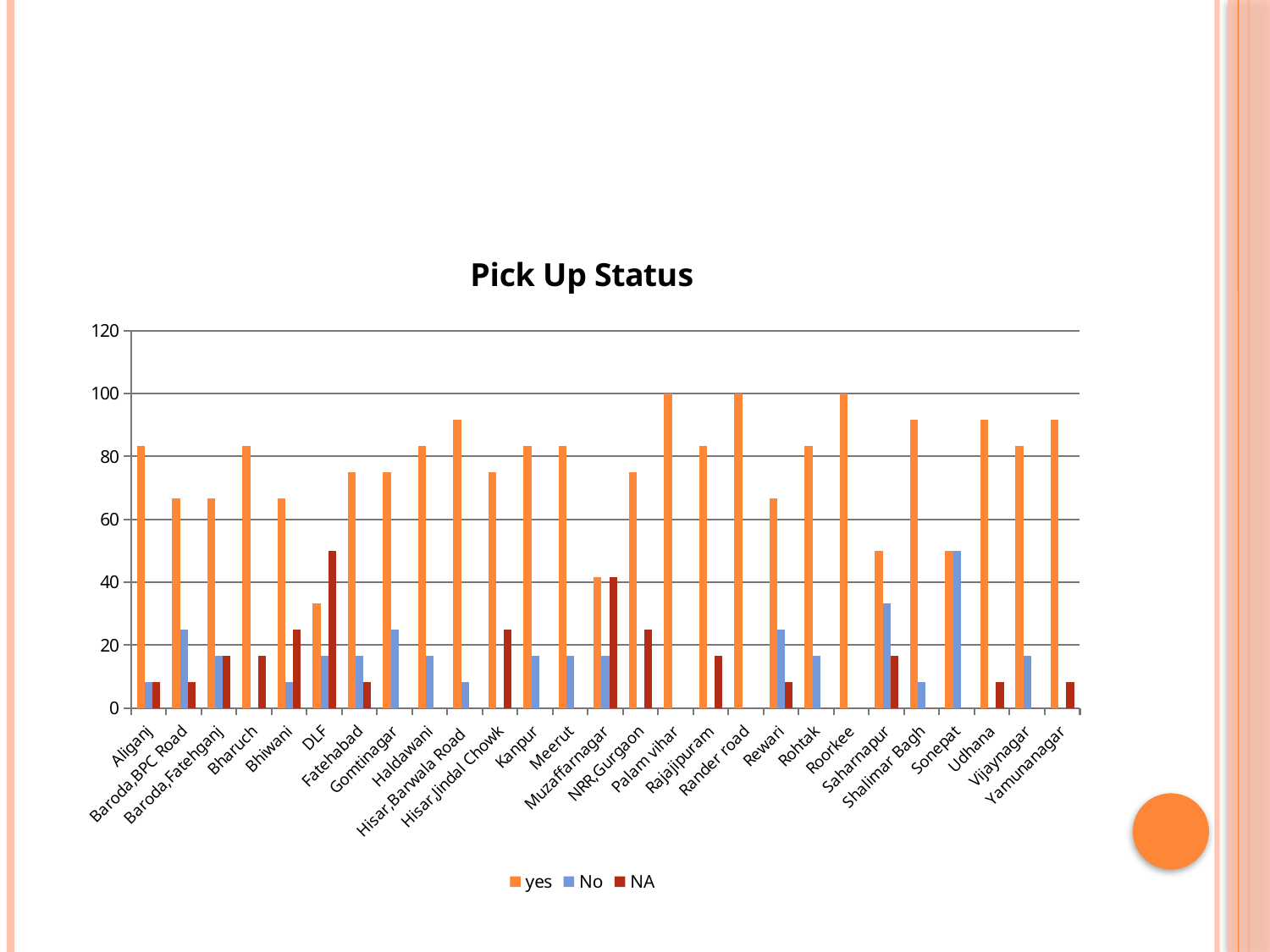
How many series does the legend list? 3 Which category has the highest 'NA' value? DLF What is the title of the chart? Pick Up Status What kind of chart is shown on the slide? bar chart Which has the larger 'yes' value, Bharuch or Bhiwani? Bharuch What are the series names listed in the legend? yes, No, NA What is the 'yes' value for Palam vihar? 100 What is the 'yes' value for Roorkee? 100 How many categories are shown on the x axis? 27 Which category has the highest 'No' value? Sonepat Is the 'yes' value for DLF greater or less than 40? less Which category has the lowest 'yes' value? DLF